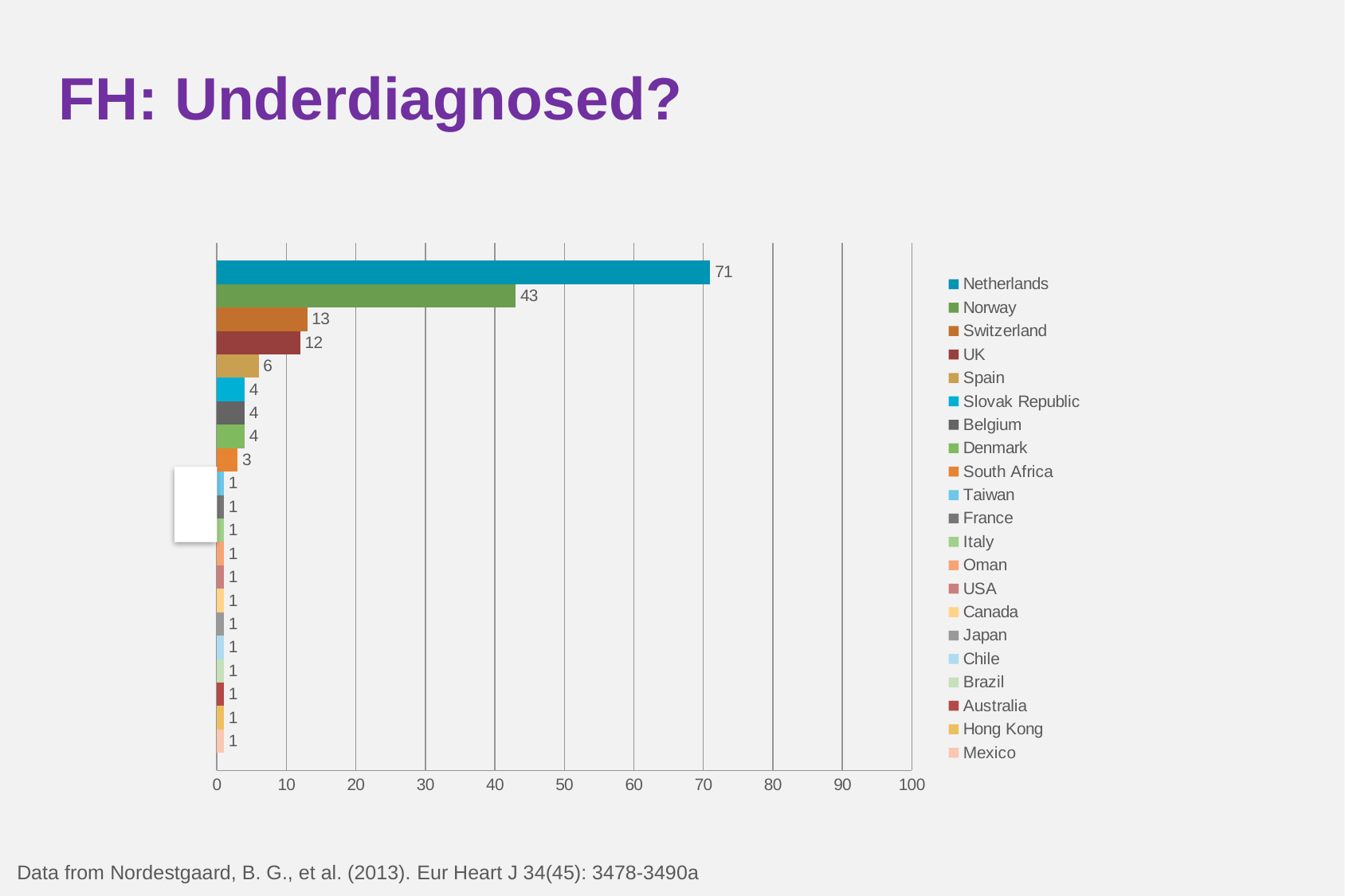
What is the value for Netherlands? 71 What is the difference between the values for Netherlands and Norway? 28 What is the value for Spain? 6 Which country has the highest value? Netherlands Which is larger, the value for Switzerland or the value for UK? Switzerland What is the value for Norway? 43 How many entries does the legend list? 21 What kind of chart is shown on the slide? bar chart How many bars are plotted in the chart? 21 What is the value for Switzerland? 13 What is the title of the slide? FH: Underdiagnosed? Is the value for Norway greater or less than 50? less